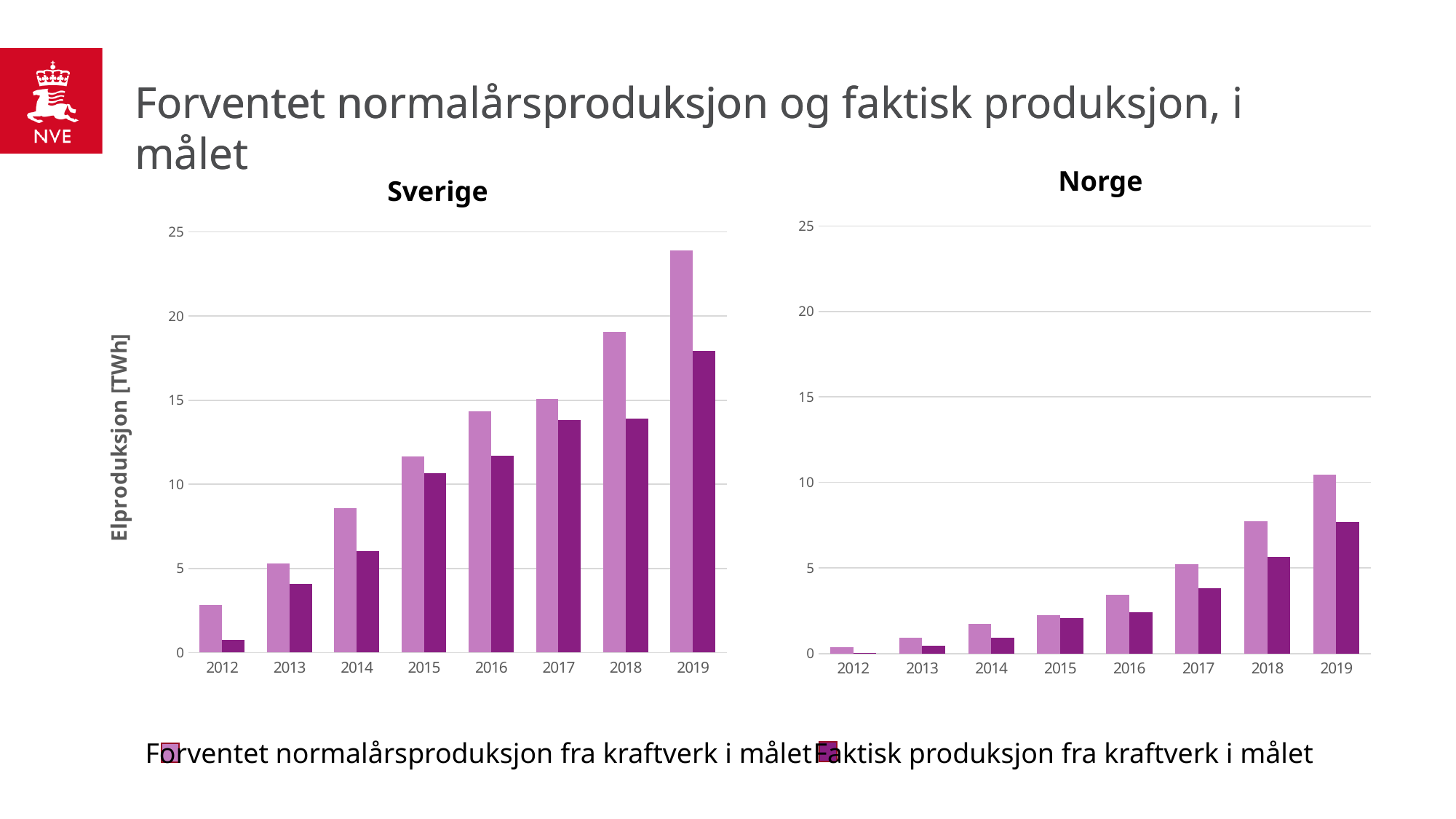
In the Sverige chart, which is larger in 2019: Forventet normalårsproduksjon fra kraftverk i målet or Faktisk produksjon fra kraftverk i målet? Forventet normalårsproduksjon fra kraftverk i målet In the Sverige chart, is the value for Faktisk produksjon fra kraftverk i målet in 2019 greater or less than 20? less In the Sverige chart, is the value for Forventet normalårsproduksjon fra kraftverk i målet in 2019 greater or less than 20? greater In the Sverige chart, which year has the highest value for Forventet normalårsproduksjon fra kraftverk i målet? 2019 In the Norge chart, is the value for Forventet normalårsproduksjon fra kraftverk i målet in 2019 greater or less than 10? greater What is the label on the y axis of the Sverige chart? Elproduksjon [TWh] What kind of chart is the Sverige chart? bar chart In the Norge chart, do the values for Forventet normalårsproduksjon fra kraftverk i målet rise or fall from 2012 to 2019? rise How many series does the legend list? 2 How many years are shown on the x axis of the Norge chart? 8 In the Norge chart, which year has the lowest value for Faktisk produksjon fra kraftverk i målet? 2012